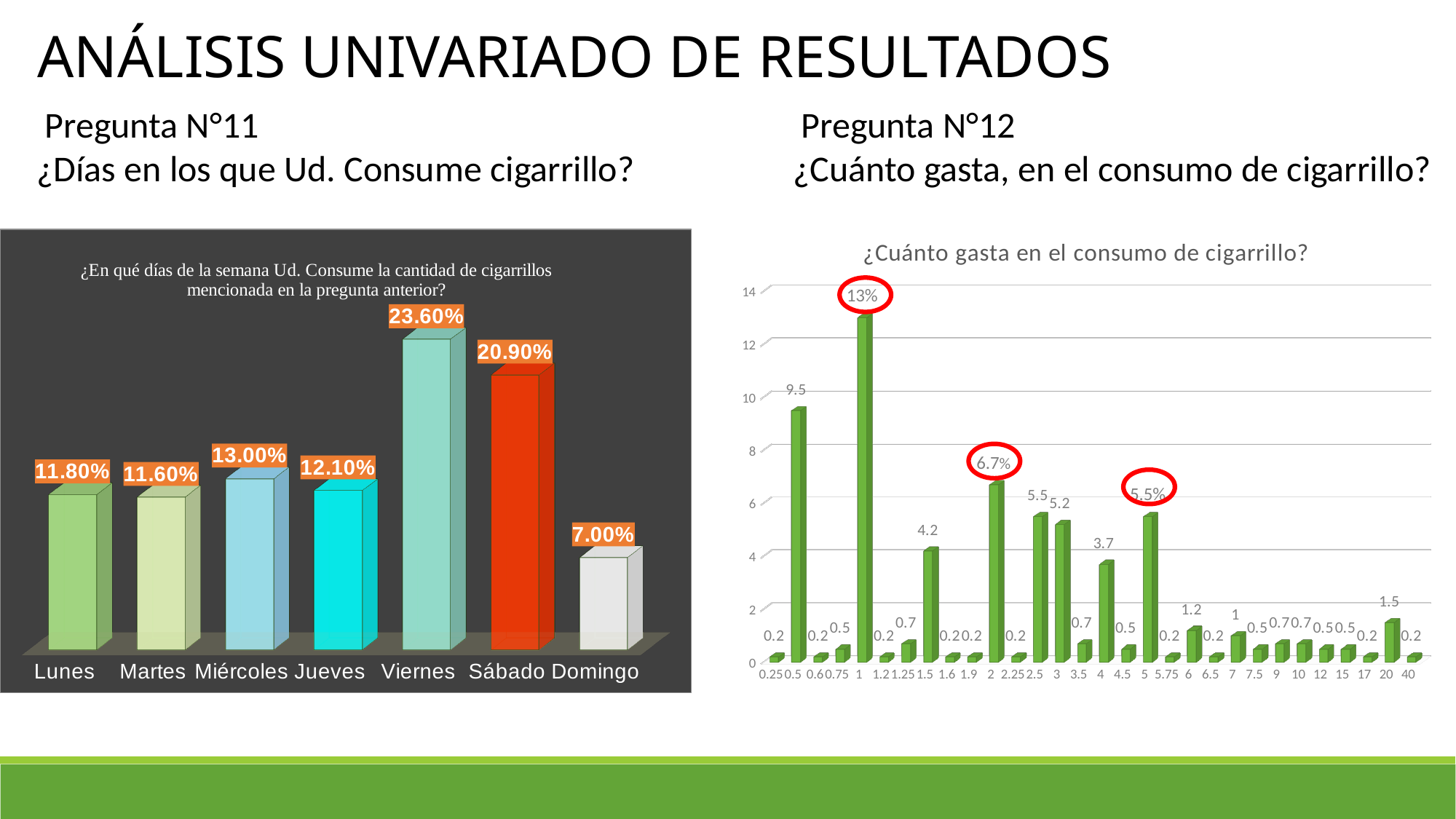
In the right chart (¿Cuánto gasta en el consumo de cigarrillo?), what is the value for the category 1.5? 4.2 In the right chart (¿Cuánto gasta en el consumo de cigarrillo?), how many categories are shown on the x axis? 30 In the right chart (¿Cuánto gasta en el consumo de cigarrillo?), which is larger, the value for category 2.5 or the value for category 4? 2.5 In the left chart (days of cigarette consumption), which day has the highest value? Viernes In the right chart (¿Cuánto gasta en el consumo de cigarrillo?), which category has the highest value? 1 In the left chart (days of cigarette consumption), which day has the lowest value? Domingo In the left chart (days of cigarette consumption), what is the difference between Viernes and Sábado? 2.70% What kind of chart is the right chart (¿Cuánto gasta en el consumo de cigarrillo?)? Bar chart In the right chart (¿Cuánto gasta en el consumo de cigarrillo?), what is the value for the category 0.5? 9.5 In the left chart (days of cigarette consumption), what is the value for Viernes? 23.60% In the left chart (days of cigarette consumption), what is the value for Domingo? 7.00% In the left chart (days of cigarette consumption), how many days are shown on the x axis? 7